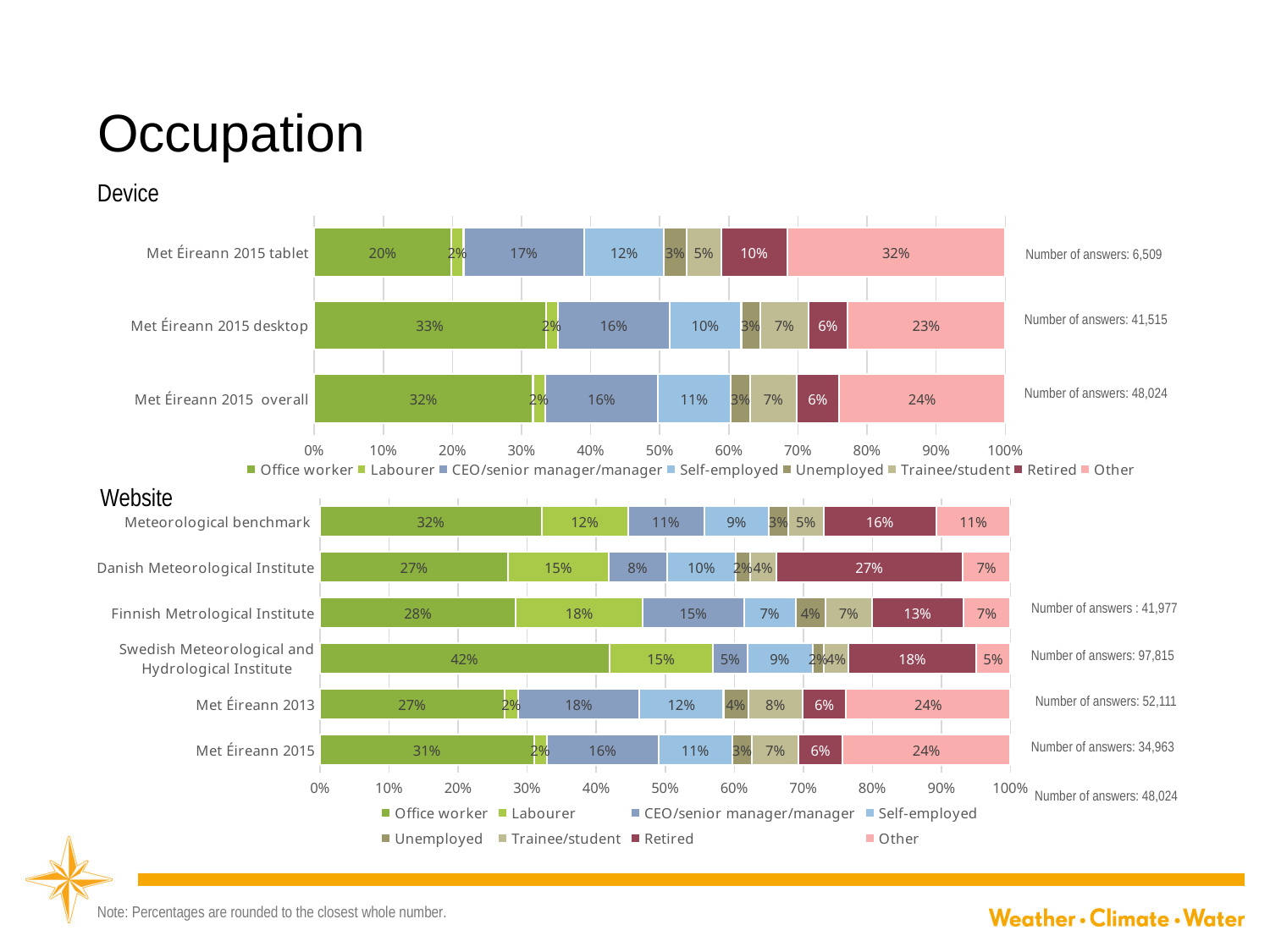
In the Website chart, what is the difference between the Other share for Met Éireann 2015 and the Meteorological benchmark? 13% In the Device chart, which category has the highest Office worker percentage? Met Éireann 2015 desktop In the Device chart, what is the difference between the Office worker share for Met Éireann 2015 desktop and Met Éireann 2015 tablet? 13% In the Website chart, how many categories are plotted? 6 In the Device chart, what is the Other share for Met Éireann 2015 tablet? 32% In the Website chart, is the Retired share larger for the Danish Meteorological Institute or for Met Éireann 2013? Danish Meteorological Institute In the Website chart, what is the Office worker percentage for the Swedish Meteorological and Hydrological Institute? 42% What kind of chart is the Device chart? Stacked bar chart In the Website chart, what is the Retired share for the Danish Meteorological Institute? 27% In the Device chart, what percentage of Met Éireann 2015 tablet respondents were Office workers? 20% In the Website chart, which category has the highest Labourer percentage? Finnish Metrological Institute In the Device chart, how many series does the legend list? 8